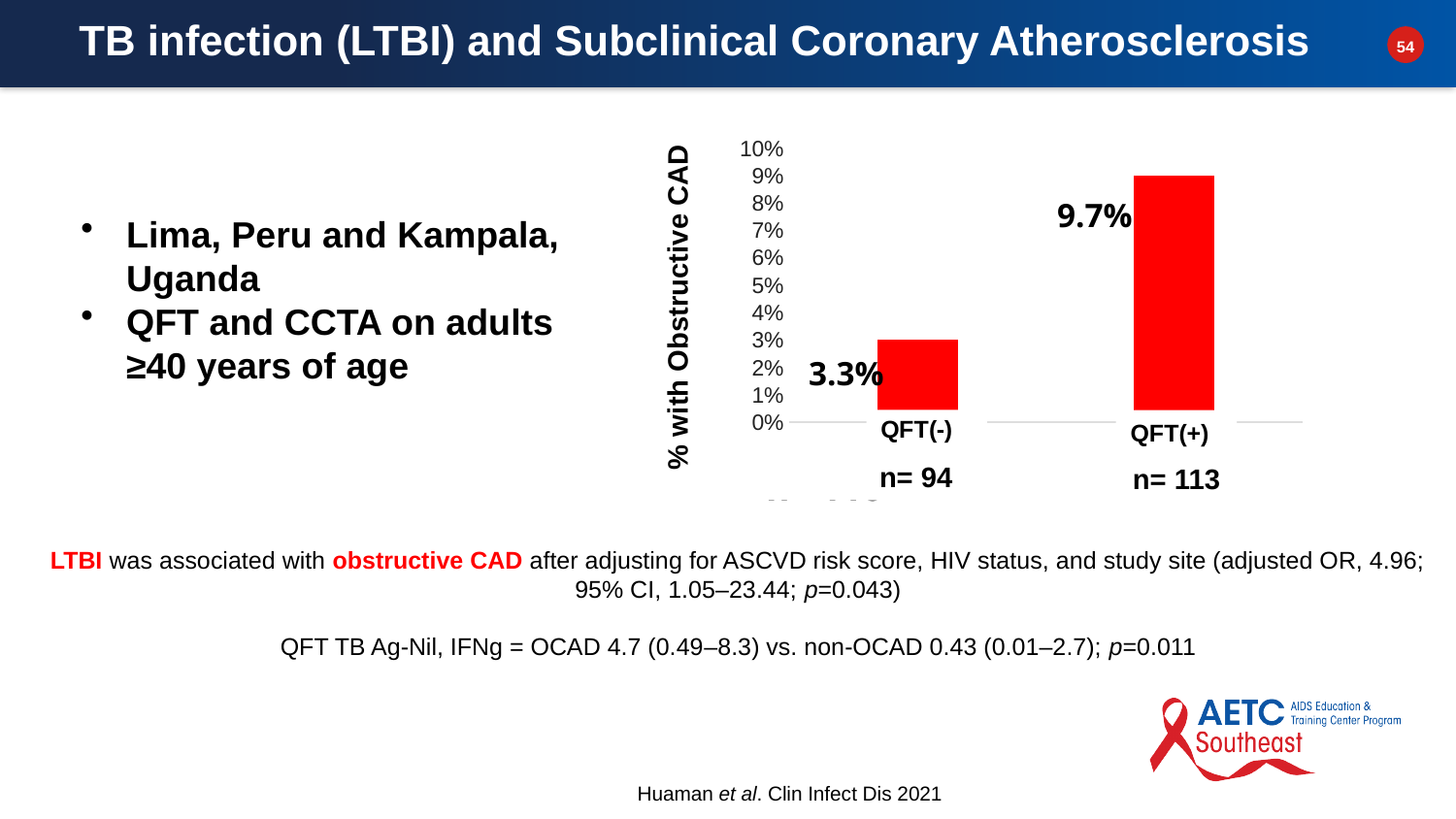
What is the value for QFT(+) in the chart? 9.7% What is the label of the y axis of the chart? % with Obstructive CAD Which category has the lowest % with Obstructive CAD? QFT(-) What is the value for QFT(-) in the chart? 3.3% What kind of chart is shown on the slide? bar chart What is the difference between the QFT(+) and QFT(-) values? 6.4% Is the value for QFT(-) greater or less than 5%? less Which category has the highest % with Obstructive CAD? QFT(+) How many categories are shown in the chart? 2 Is the value for QFT(+) greater or less than 8%? greater What is the sample size (n) shown for the QFT(+) group? n= 113 Which is larger, the value for QFT(-) or the value for QFT(+)? QFT(+)